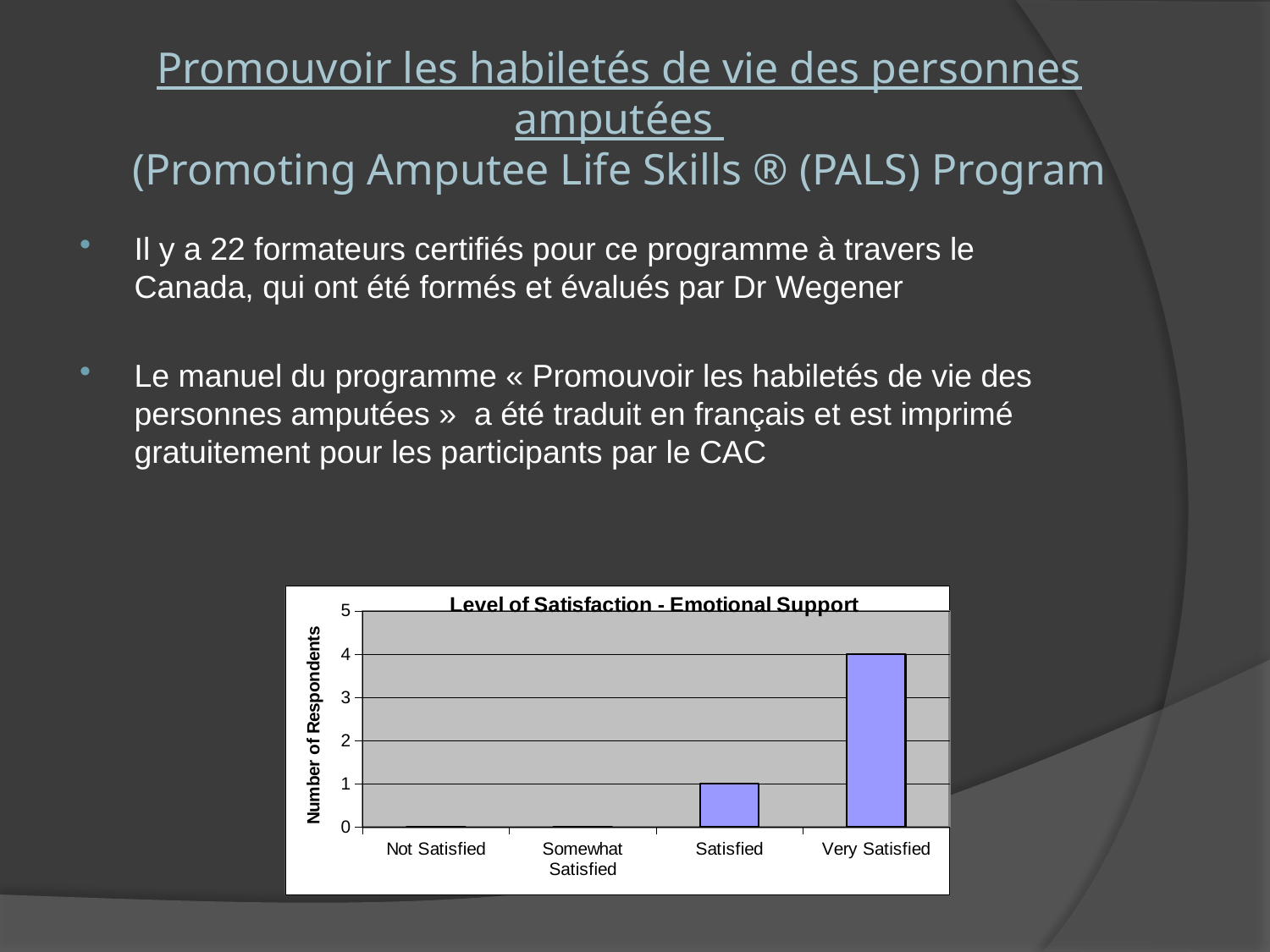
What kind of chart is shown on the slide? bar chart What is the difference in number of respondents between Very Satisfied and Satisfied? 3 What is the title of the chart? Level of Satisfaction - Emotional Support Which has more respondents, Satisfied or Very Satisfied? Very Satisfied How many respondents are in the Not Satisfied category? 0 How many respondents are in the Very Satisfied category? 4 What is the label of the vertical axis of the chart? Number of Respondents How many respondents are in the Satisfied category? 1 Do the values rise or fall moving from Not Satisfied to Very Satisfied along the x axis? rise Is the value for Very Satisfied greater or less than 3? greater Which category has the highest number of respondents? Very Satisfied How many categories are shown on the x axis of the chart? 4